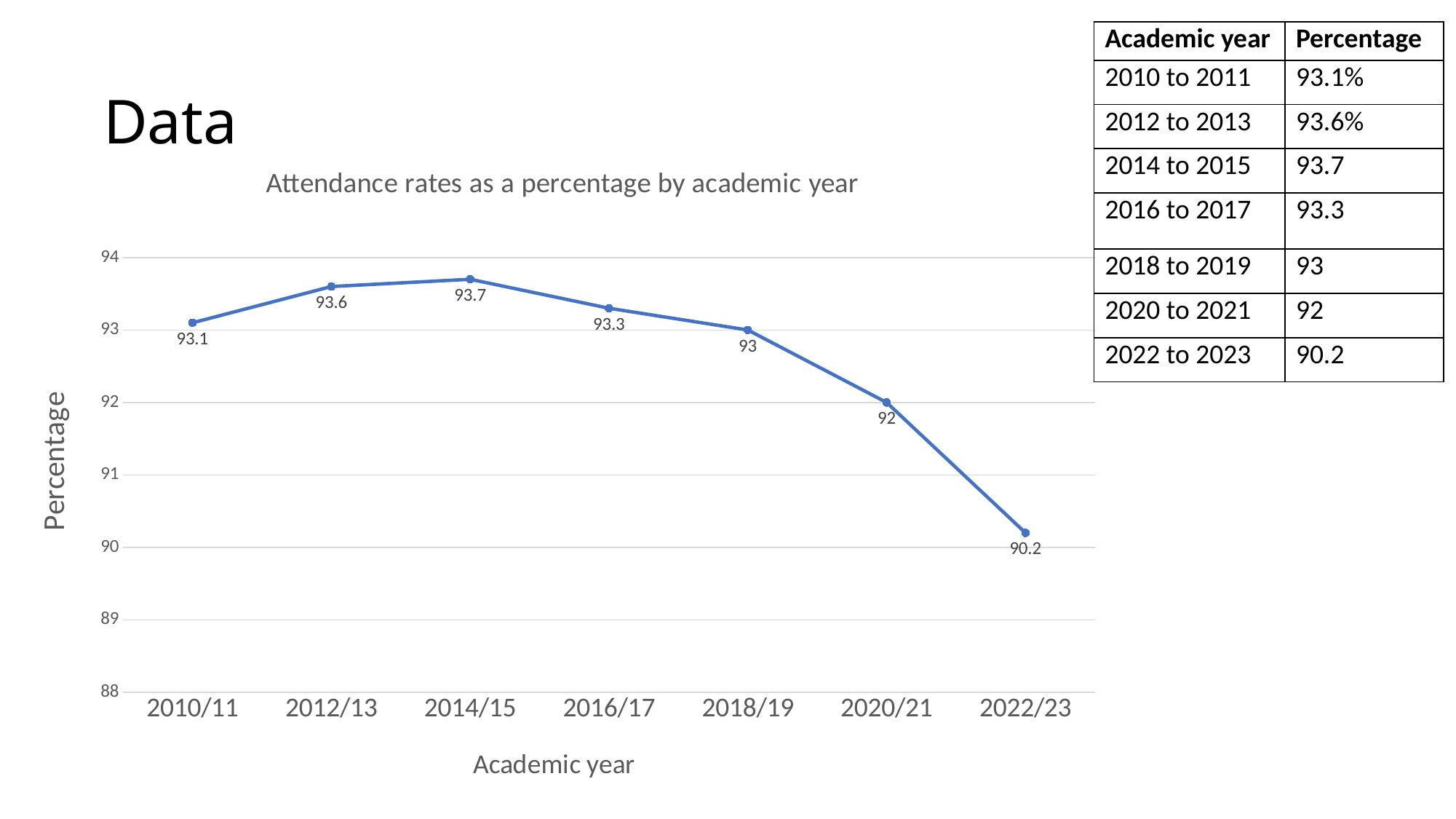
Is the value for 2020/21 greater or less than 91? greater Which academic year has the lowest attendance rate? 2022/23 What kind of chart is shown on the slide? line chart What is the attendance rate for 2018/19? 93 What is the attendance rate for 2022/23? 90.2 Which academic year has the highest attendance rate? 2014/15 How many academic years are plotted on the chart? 7 What is the attendance rate for 2014/15? 93.7 Which has a higher attendance rate, 2010/11 or 2012/13? 2012/13 What is the difference between the attendance rates for 2014/15 and 2022/23? 3.5 What is the title of the chart? Attendance rates as a percentage by academic year What is the difference between the attendance rates for 2020/21 and 2022/23? 1.8